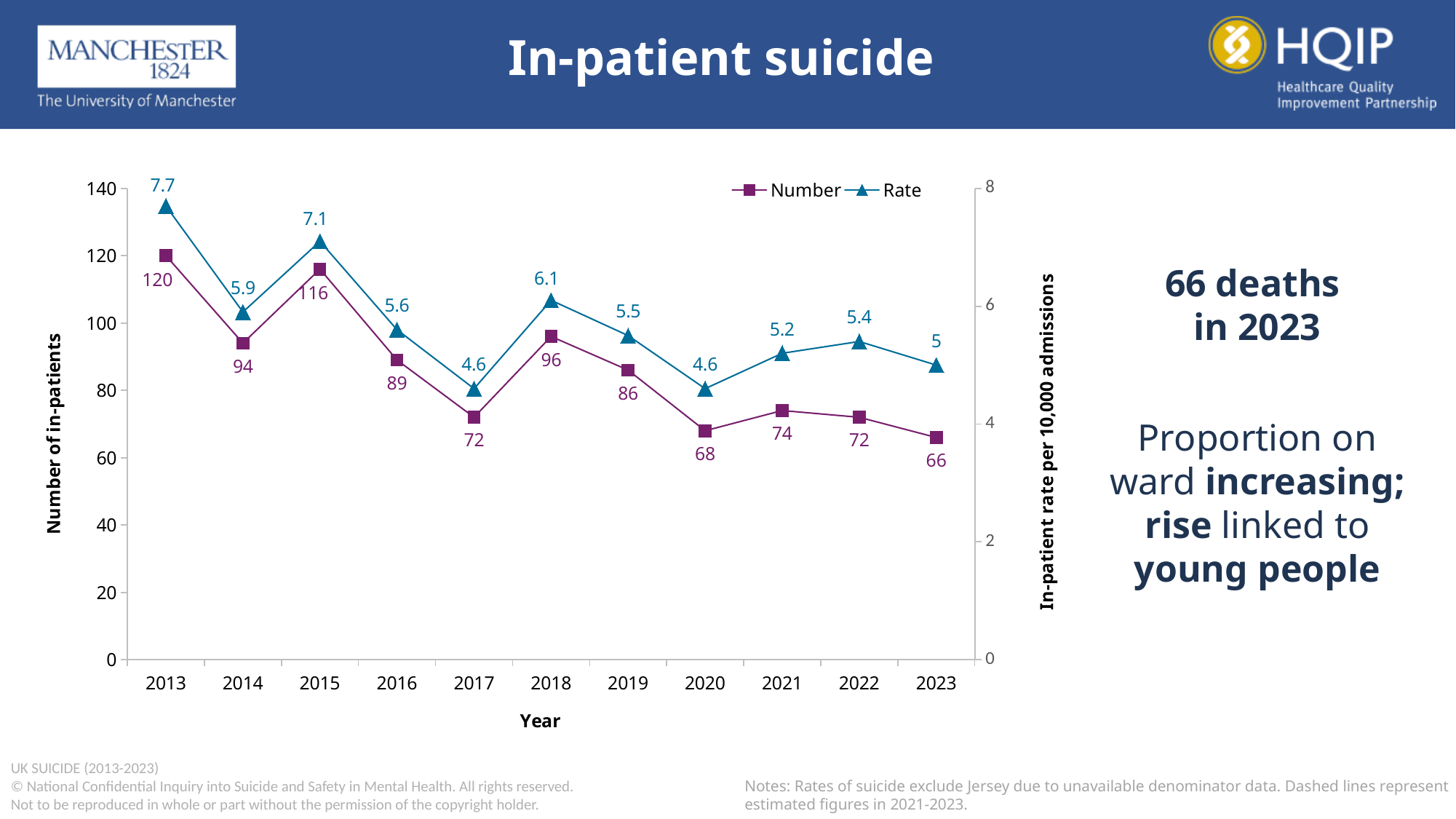
What is the label of the right-hand y axis? In-patient rate per 10,000 admissions What is the Rate per 10,000 admissions in 2018? 6.1 In which year is the Rate lowest? 2017 and 2020 What is the Number of in-patients in 2013? 120 In which year is the Number of in-patients highest? 2013 What is the difference between the Number of in-patients in 2013 and in 2023? 54 How many series does the legend list? 2 Which year has a higher Rate, 2015 or 2019? 2015 What is the Number of in-patients in 2023? 66 How many years are plotted on the x axis? 11 What kind of chart is shown on the slide? Line chart Does the Number of in-patients generally rise or fall from 2013 to 2023? Fall